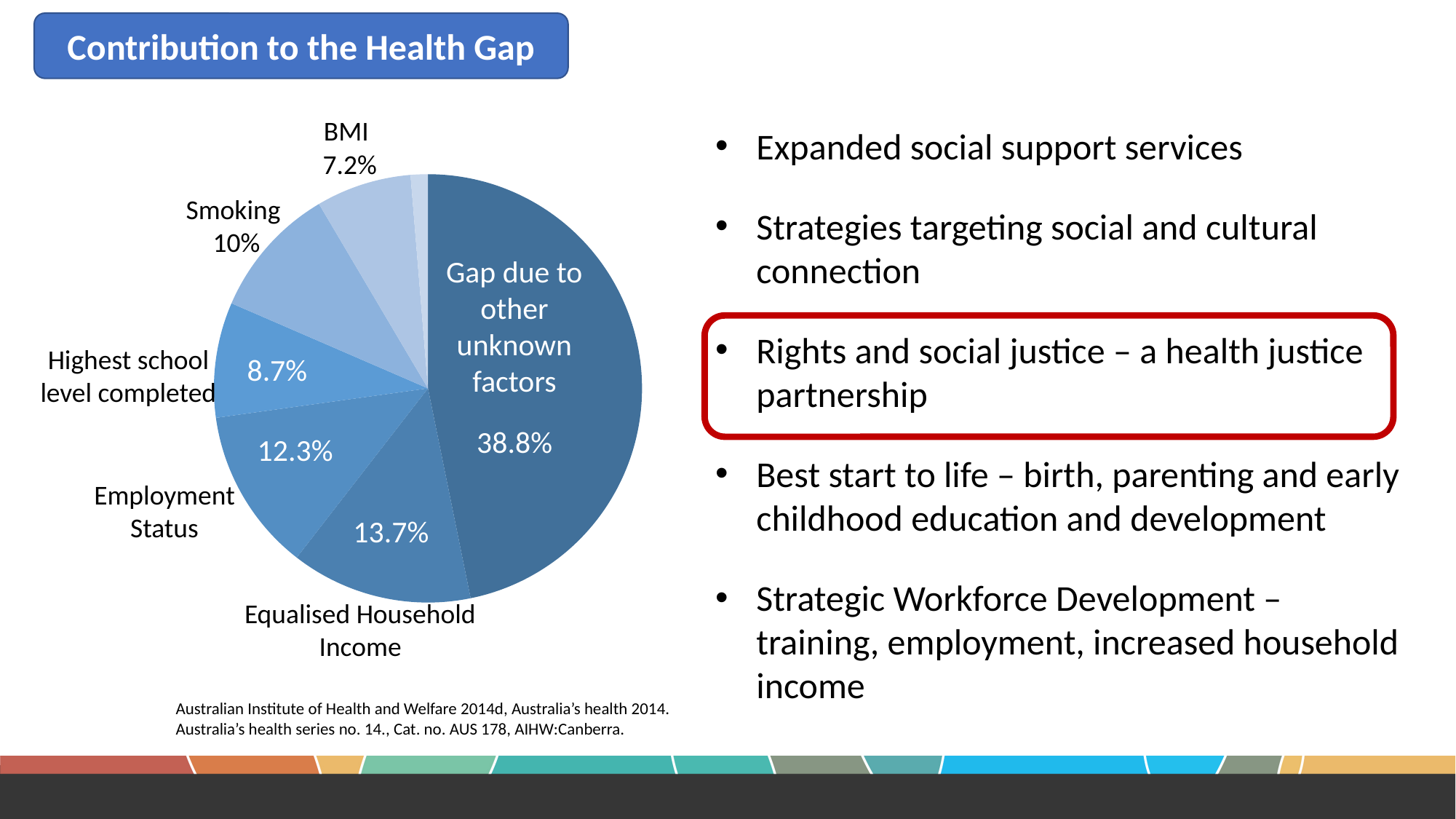
What is the value for Equalised Household Income? 13.7% Which is larger, Employment Status or Smoking? Employment Status What type of chart is shown on the slide? pie chart What is the title of the chart? Contribution to the Health Gap What is the value for Smoking? 10% What is the difference between Equalised Household Income and Employment Status? 1.4% What is the value for BMI? 7.2% What is the difference between Smoking and BMI? 2.8% What percentage of the health gap is due to other unknown factors? 38.8% Which slice of the pie is the largest? Gap due to other unknown factors What is the value for Highest school level completed? 8.7% What is the value for Employment Status? 12.3%